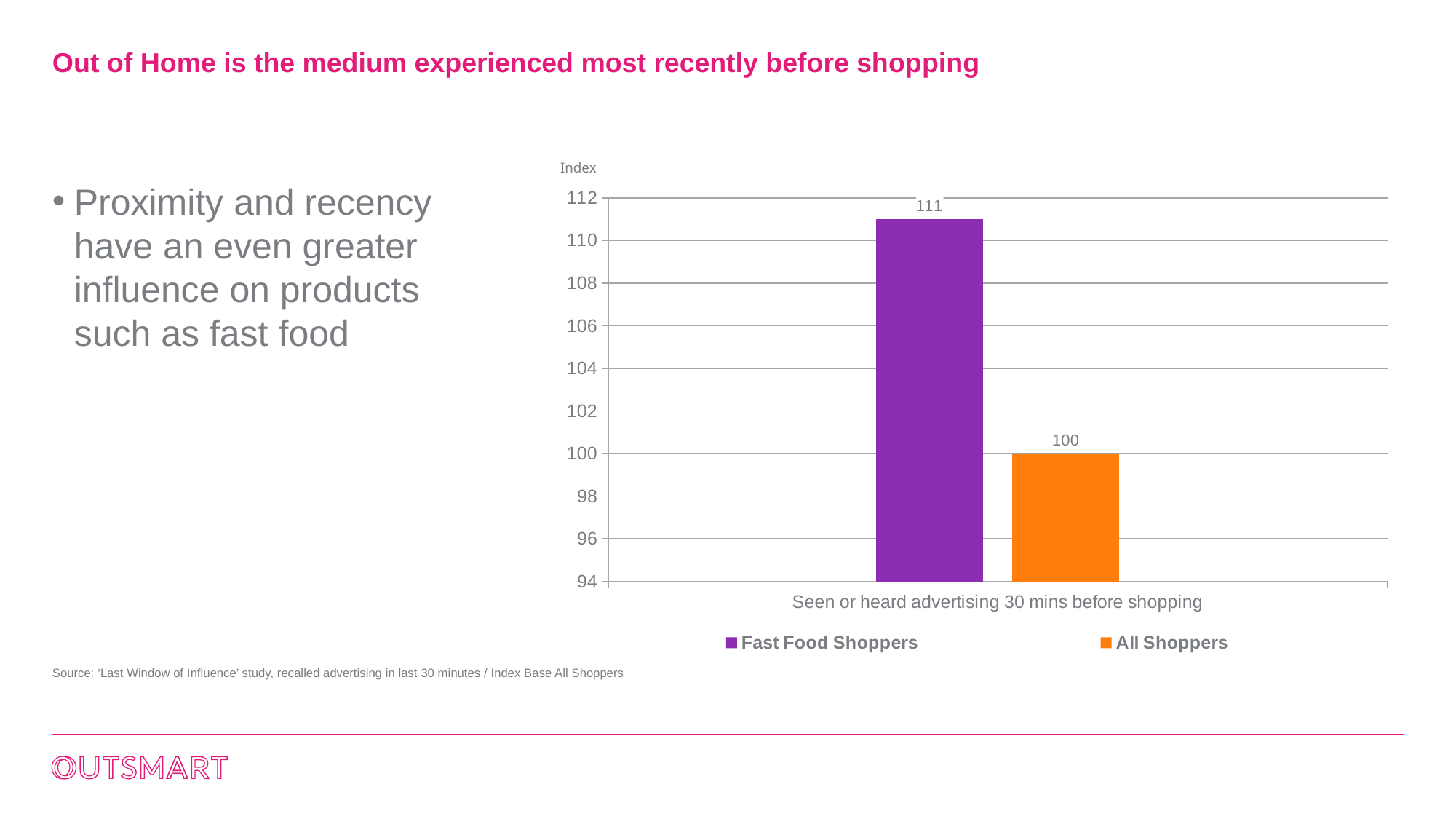
Is the value for Fast Food Shoppers greater or less than 108? greater What is the lowest value shown on the y axis? 94 How many series does the legend list? 2 What colour is the bar for All Shoppers? orange Which series has the higher index value? Fast Food Shoppers What is the difference between the Fast Food Shoppers index and the All Shoppers index? 11 Which series has the lower index value? All Shoppers Is the value for Fast Food Shoppers larger or smaller than the value for All Shoppers? larger What is the index value for All Shoppers? 100 What is the label on the x axis of the chart? Seen or heard advertising 30 mins before shopping What is the index value for Fast Food Shoppers? 111 What kind of chart is shown on the slide? bar chart